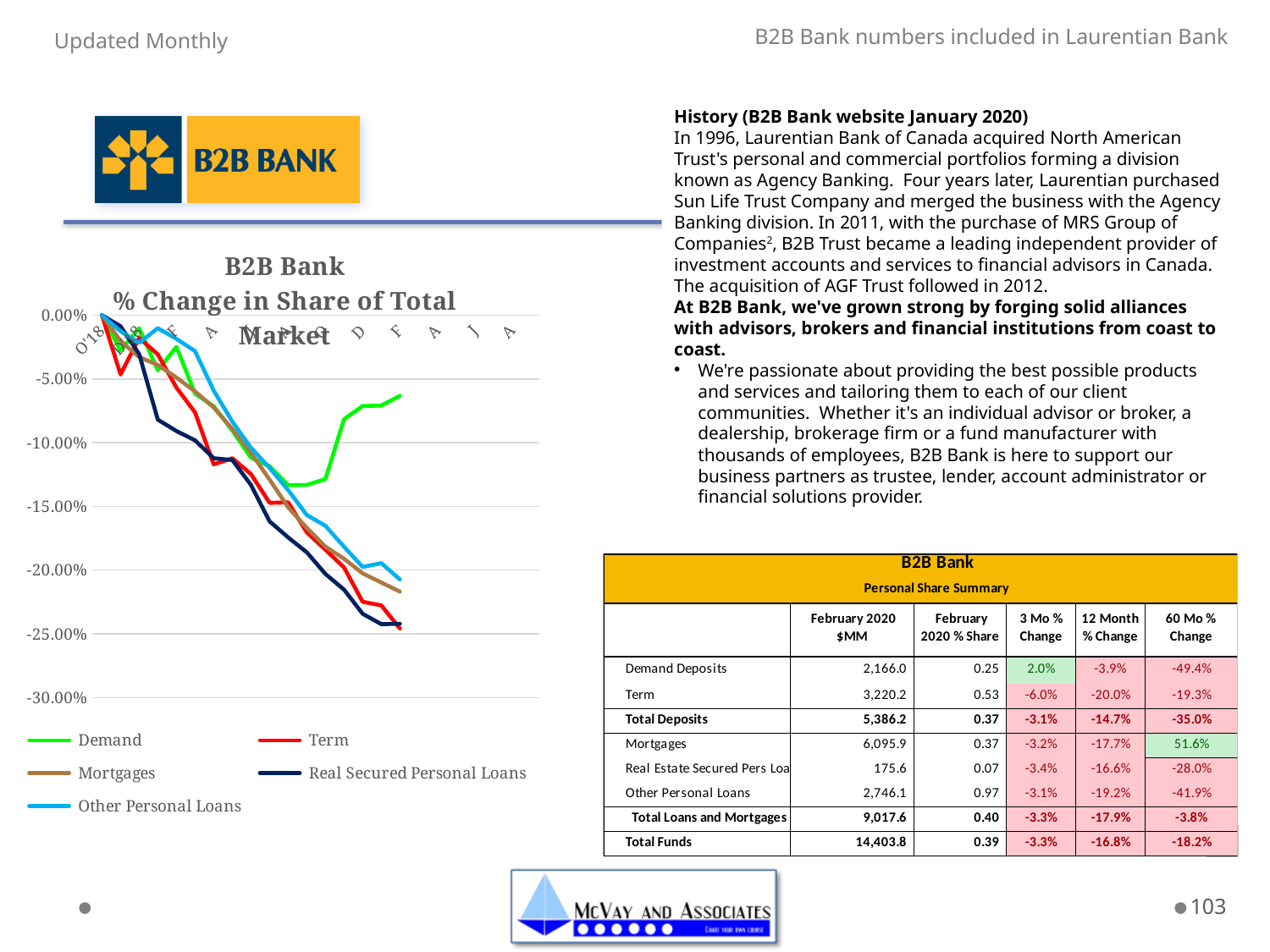
What is the title of the chart? B2B Bank % Change in Share of Total Market Which series has the highest value at the right end of the chart? Demand At the right end of the chart, which series has the higher value, Demand or Term? Demand Is the final value for the Demand series greater or less than -10.00%? greater Do the values for the Term series generally rise or fall along the x axis? fall How many series does the chart legend list? 5 What kind of chart is shown on the slide? line chart Is the final value for the Real Secured Personal Loans series greater or less than -20.00%? less Do the values for the Mortgages series generally rise or fall along the x axis? fall Is the final value for the Term series greater or less than -20.00%? less Which colour is used for the Demand series in the chart? green What value do all the series start at on the left of the chart? 0.00%